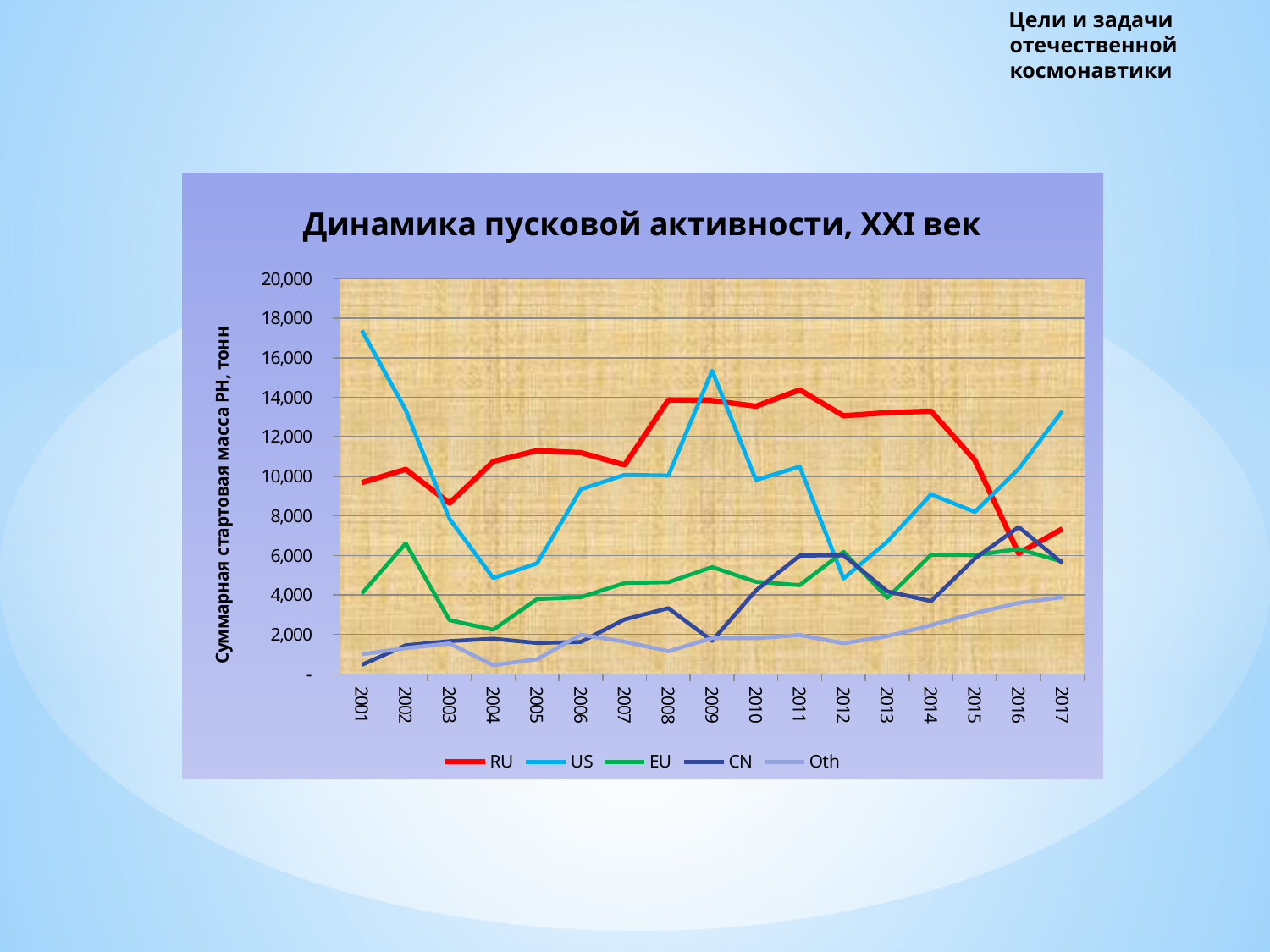
Is the value for RU in 2001 greater or less than 10,000? less Which is larger in 2017, the value for US or the value for RU? US How many series does the legend list? 5 How many years are plotted along the x axis? 17 Which series has the highest value in 2011? RU What kind of chart is shown on the slide? line chart What is the title of the chart? Динамика пусковой активности, XXI век Which series has the highest value in 2001? US Does the US series rise or fall from 2001 to 2004? fall Which series has the lowest value in 2001? CN Is the value for US in 2001 greater or less than 16,000? greater Is the value for CN in 2001 greater or less than 2,000? less